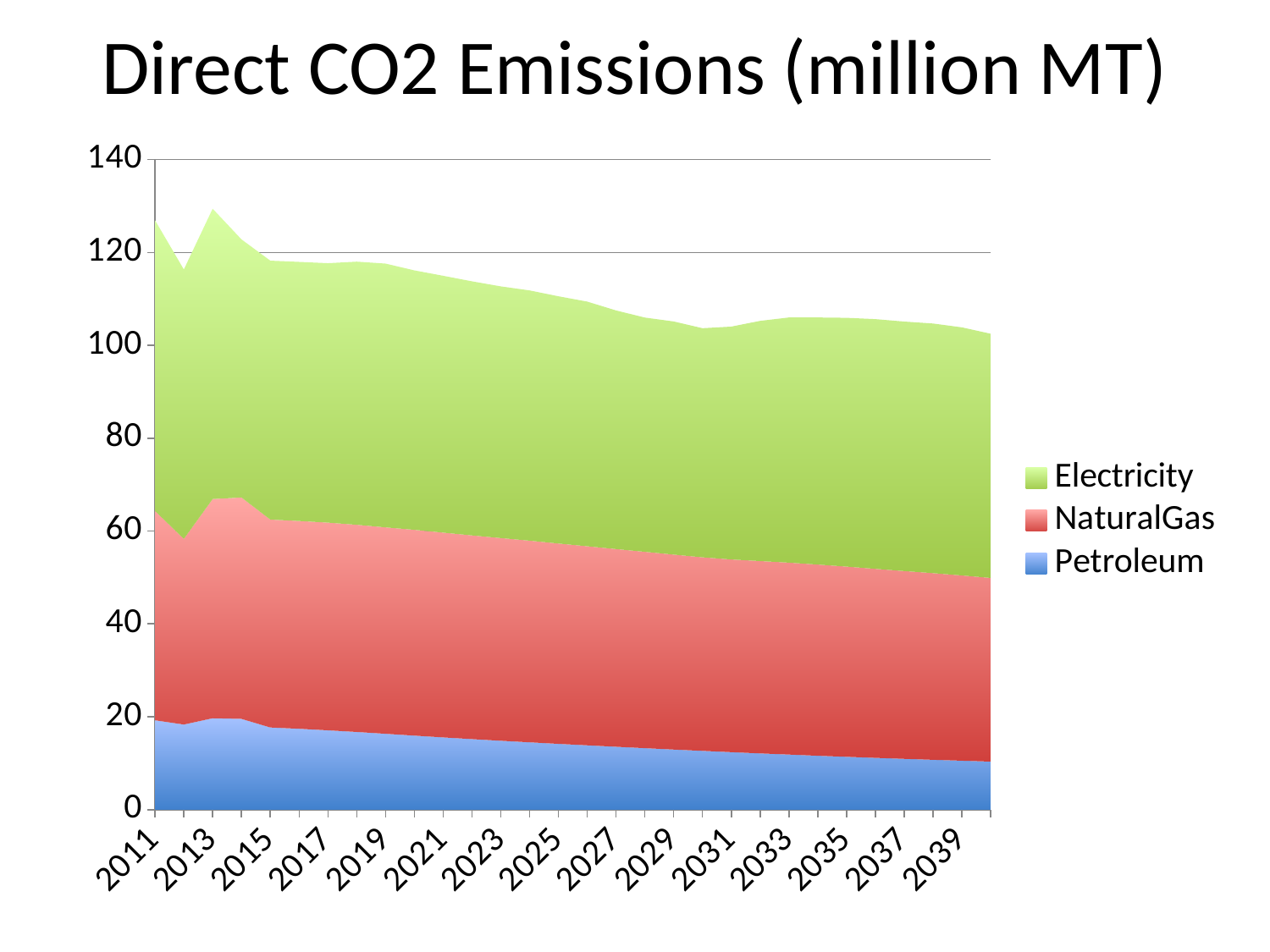
Which series is shown in green in the chart? Electricity Which series forms the bottom layer of the stacked area chart? Petroleum What is the title of the chart? Direct CO2 Emissions (million MT) Is the total direct CO2 emissions value in 2039 greater or less than 120? less Do total direct CO2 emissions rise or fall from 2011 to 2039? Fall Does the Petroleum series rise or fall over the period shown? Fall Is the Petroleum value in 2039 greater or less than 20? less Is the total direct CO2 emissions value in 2031 greater or less than 100? greater How many series does the legend list? 3 Which series contributes the largest share of emissions throughout the period? Electricity What kind of chart is shown on the slide? Stacked area chart